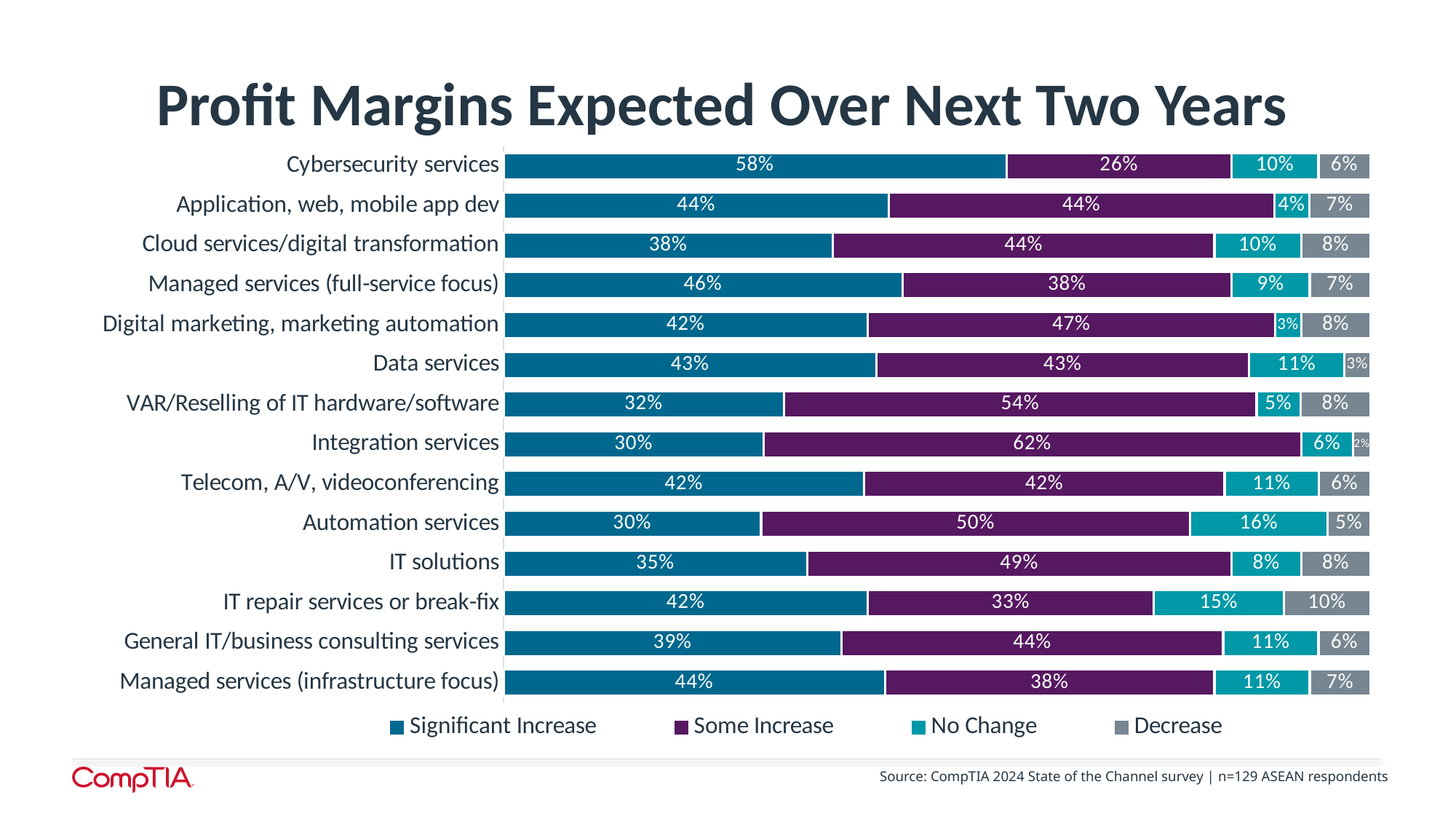
What kind of chart is shown on the slide? Stacked bar chart Which is larger: the Significant Increase value for Managed services (full-service focus) or for Cloud services/digital transformation? Managed services (full-service focus) How many series does the legend list? 4 What percentage of respondents expect a Significant Increase in profit margins for Cybersecurity services? 58% What is the difference between the Significant Increase and Some Increase values for Cybersecurity services? 32 percentage points What is the Some Increase value for Integration services? 62% What is the No Change value for Automation services? 16% Which category has the highest Decrease value? IT repair services or break-fix What is the Decrease value for IT repair services or break-fix? 10% How many categories are shown in the chart? 14 Which category has the lowest Some Increase value? Cybersecurity services Which category has the highest Significant Increase value? Cybersecurity services